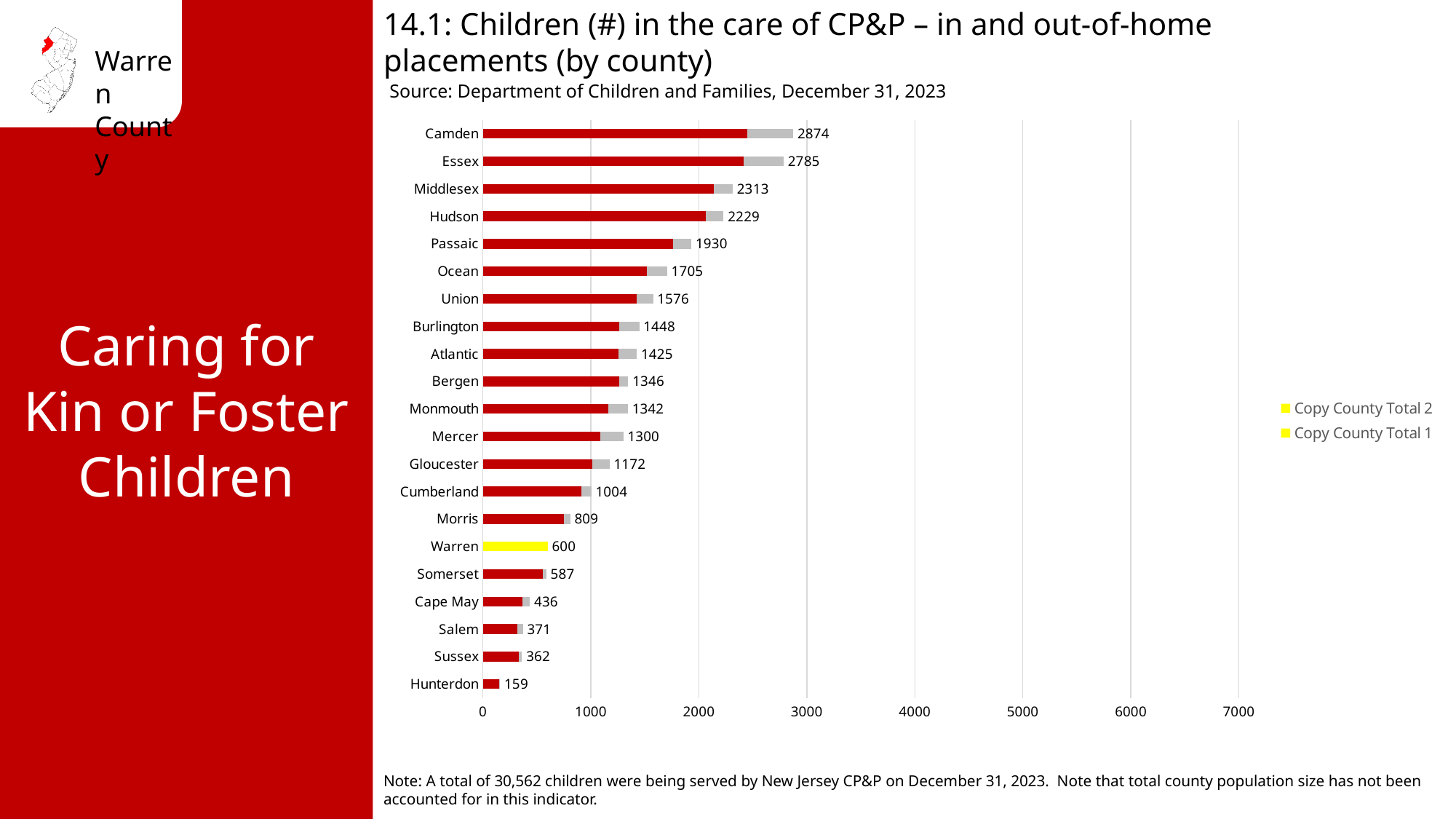
Which county has the highest value? Camden How many counties are shown on the chart? 21 What is the difference between the values for Camden and Essex? 89 What is the value shown for Camden? 2874 Which has a larger value, Ocean or Union? Ocean Which county has the lowest value? Hunterdon How many series does the legend list? 2 What kind of chart is shown on the slide? bar chart What is the difference between the values for Warren and Somerset? 13 Is the value for Passaic greater or less than 2000? less What is the value shown for Warren? 600 What is the value shown for Hunterdon? 159